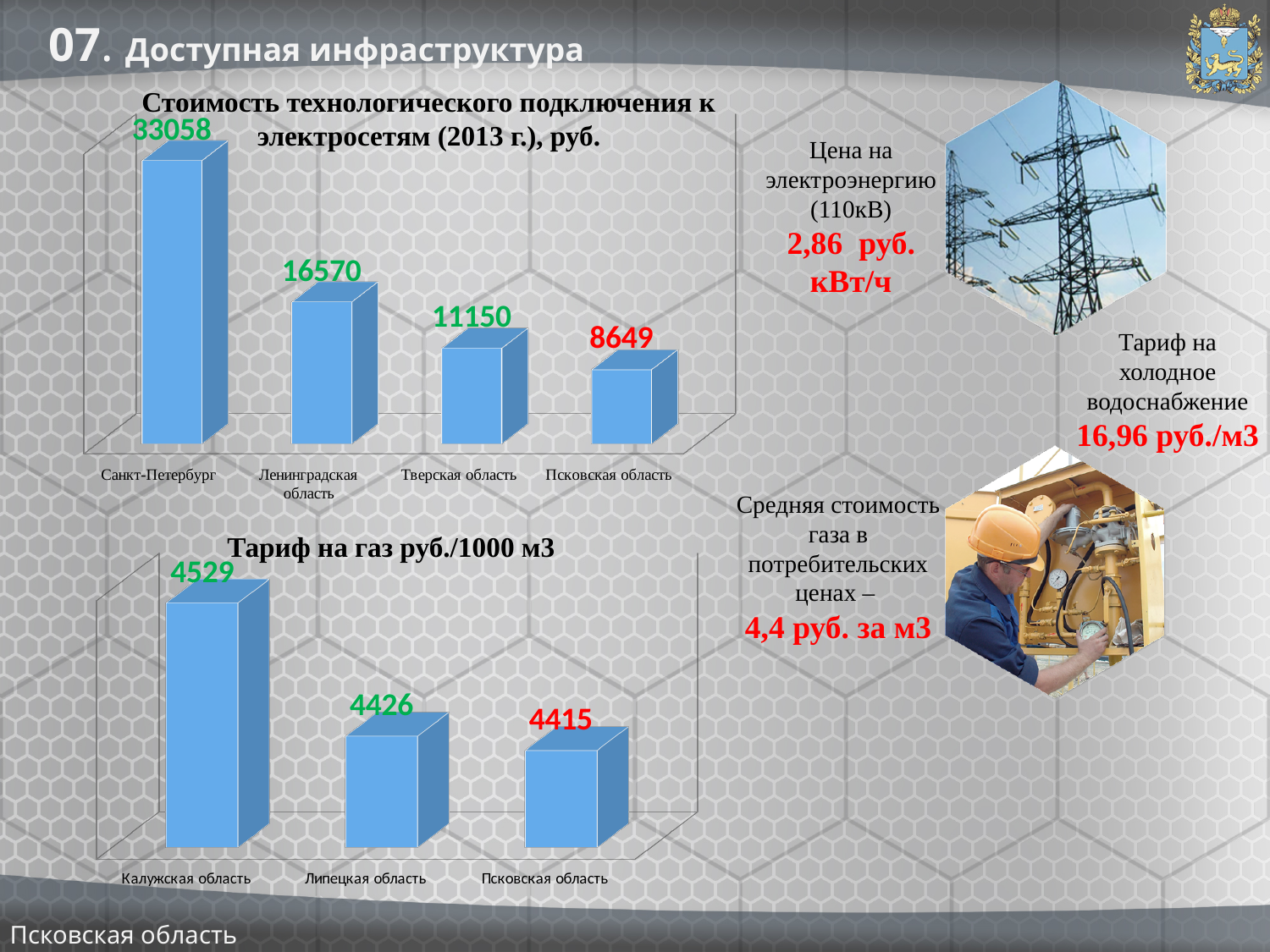
What type of chart is 'Тариф на газ руб./1000 м3'? bar chart In the chart 'Тариф на газ руб./1000 м3', which is larger, Липецкая область or Псковская область? Липецкая область In the chart 'Стоимость технологического подключения к электросетям (2013 г.), руб.', what is the difference between Санкт-Петербург and Псковская область? 24409 In the chart 'Стоимость технологического подключения к электросетям (2013 г.), руб.', which category has the lowest value? Псковская область In the chart 'Стоимость технологического подключения к электросетям (2013 г.), руб.', do the values rise or fall from left to right? fall In the chart 'Стоимость технологического подключения к электросетям (2013 г.), руб.', how many categories are shown? 4 In the chart 'Тариф на газ руб./1000 м3', what is the value for Псковская область? 4415 In the chart 'Тариф на газ руб./1000 м3', what is the difference between Калужская область and Псковская область? 114 In the chart 'Тариф на газ руб./1000 м3', what is the value for Калужская область? 4529 In the chart 'Стоимость технологического подключения к электросетям (2013 г.), руб.', which category has the highest value? Санкт-Петербург In the chart 'Стоимость технологического подключения к электросетям (2013 г.), руб.', what is the value for Санкт-Петербург? 33058 In the chart 'Стоимость технологического подключения к электросетям (2013 г.), руб.', what is the value for Тверская область? 11150